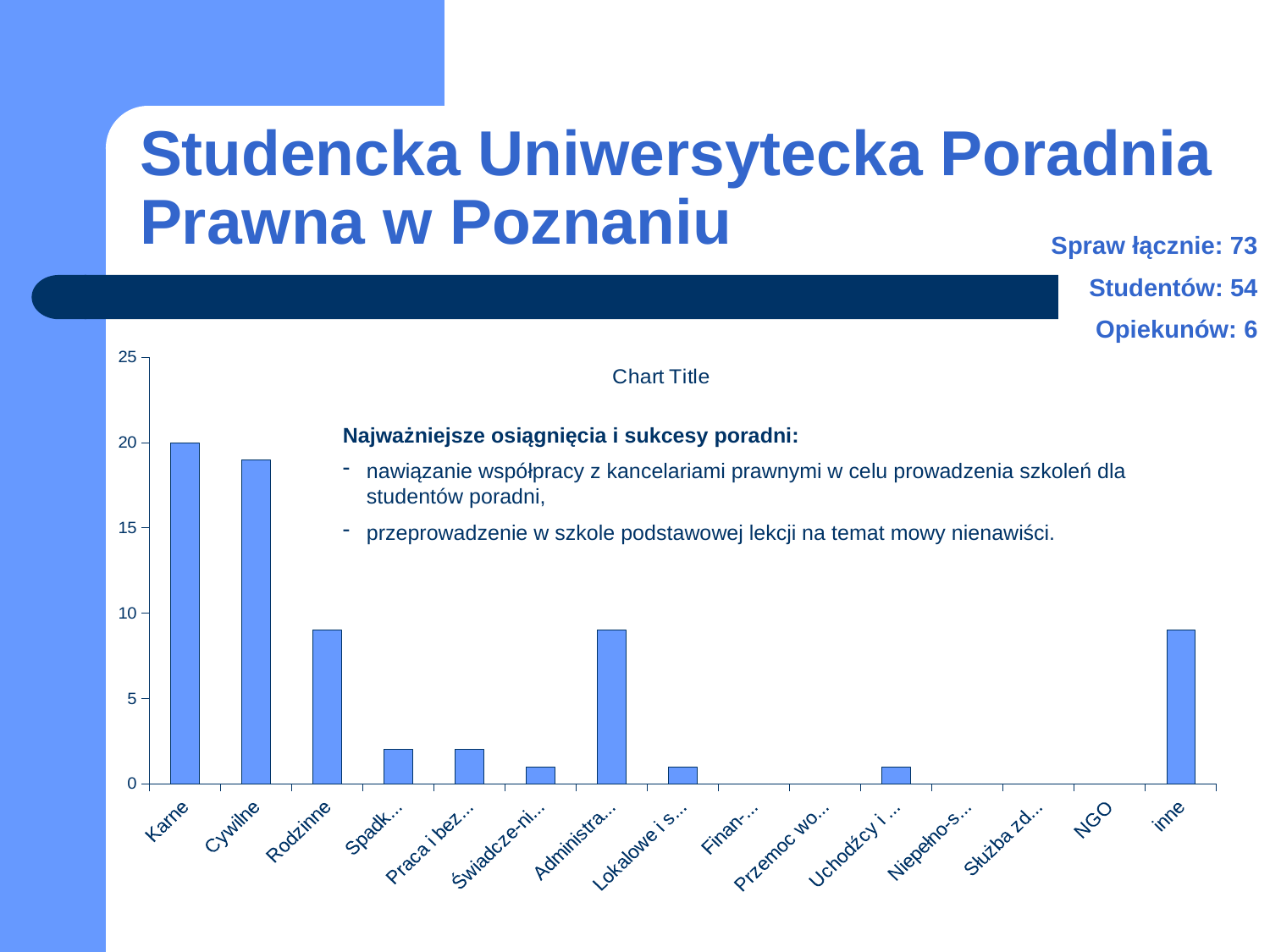
Is the value for inne greater or less than 10? less What is the value for Karne in the chart? 20 Which is larger, the value for Rodzinne or the value for Spadk...? Rodzinne Is the value for Cywilne greater or less than 15? greater Is the value for Spadk... greater or less than 5? less Which category has the highest bar in the chart? Karne What is the title shown on the chart? Chart Title What kind of chart is shown on the slide? bar chart Which is larger, the value for Karne or the value for Rodzinne? Karne Which is larger, the value for Cywilne or the value for inne? Cywilne How many categories are shown on the x axis of the chart? 15